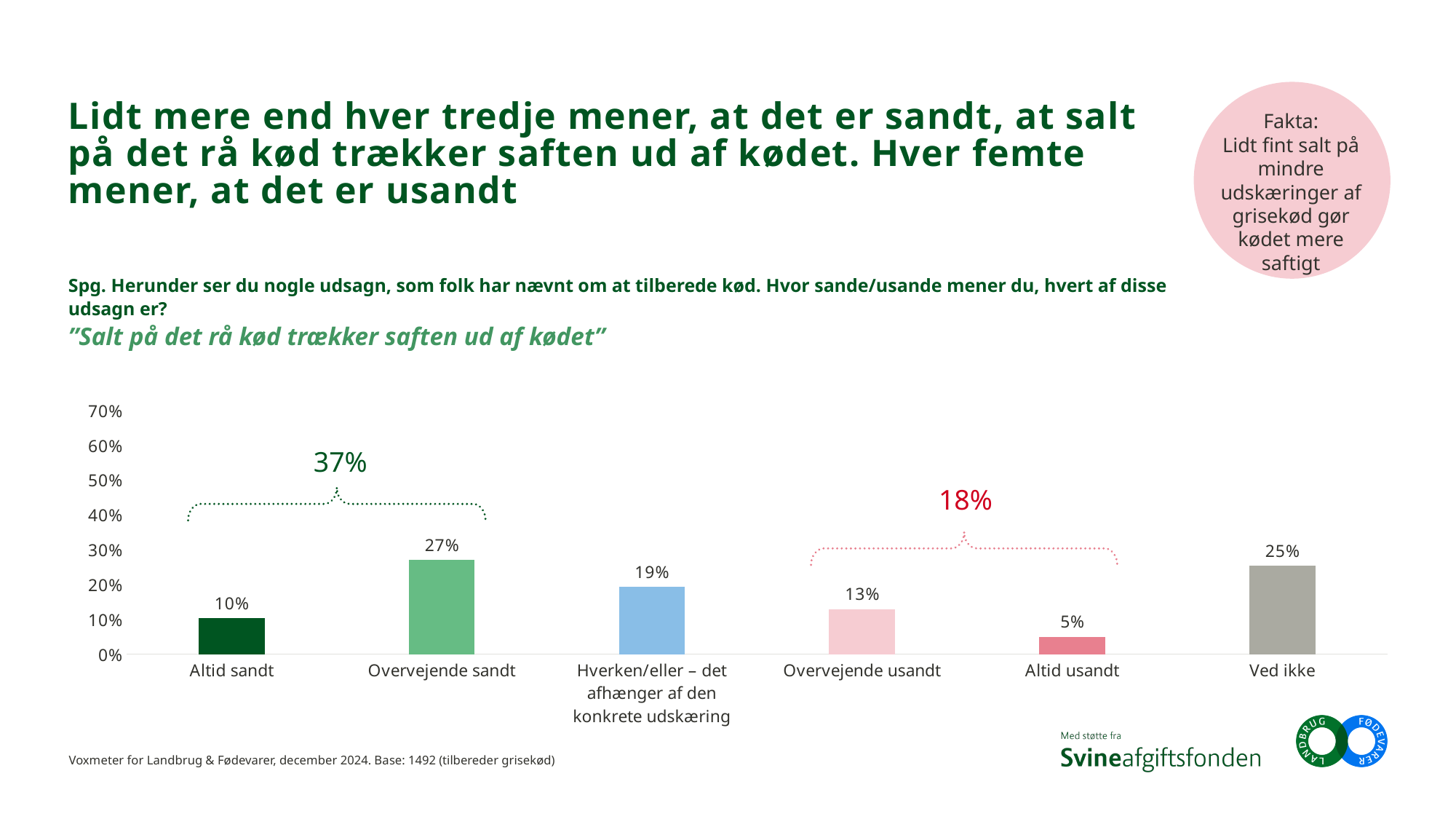
Which category has the lowest value? Altid usandt What is the combined total of "Overvejende usandt" and "Altid usandt" as shown by the bracket label? 18% What is the value for "Ved ikke"? 25% Which is larger, "Ved ikke" or "Hverken/eller – det afhænger af den konkrete udskæring"? Ved ikke How many categories are shown on the x axis? 6 What kind of chart is shown? Bar chart What is the difference between "Overvejende sandt" and "Overvejende usandt"? 14 percentage points What is the value for "Overvejende sandt"? 27% What is the combined total of "Altid sandt" and "Overvejende sandt" as shown by the bracket label? 37% Which category has the highest value? Overvejende sandt What is the value for "Hverken/eller – det afhænger af den konkrete udskæring"? 19% What is the value for "Altid sandt"? 10%